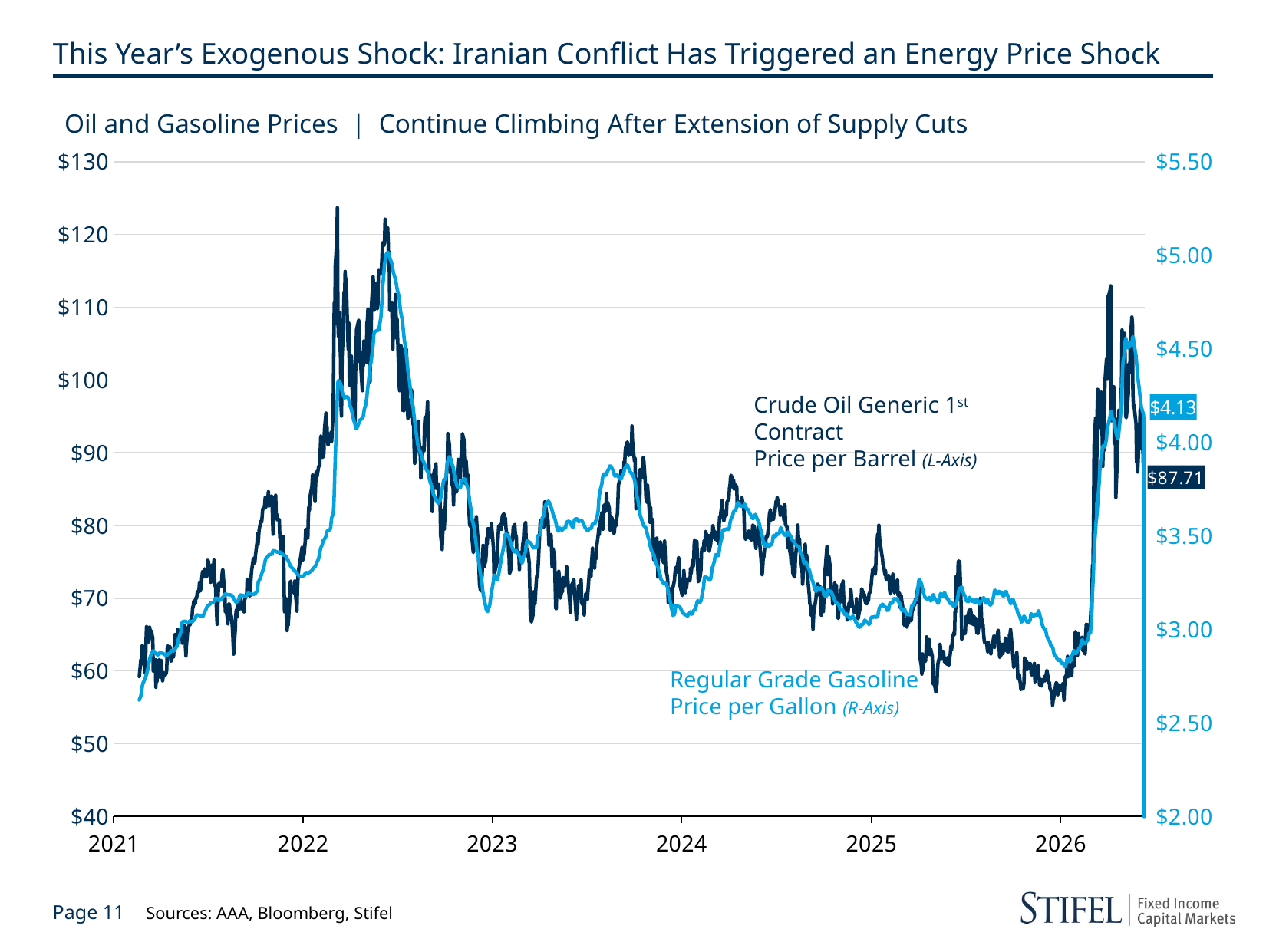
What is the latest labelled value for the Crude Oil Generic 1st Contract Price per Barrel? $87.71 Is the crude oil price per barrel at the start of 2021 greater or less than $70? less What is the latest labelled value for the Regular Grade Gasoline Price per Gallon? $4.13 Is the lowest crude oil price per barrel in late 2025 greater or less than $60? less Is the peak crude oil price per barrel reached in 2022 greater or less than $120? greater Which axis is the Regular Grade Gasoline Price per Gallon plotted against? R-Axis (right axis) How many years are labelled on the x axis? 6 What kind of chart is shown on the slide? line chart Does the crude oil price per barrel rise or fall from its 2022 peak to the end of 2023? fall How many data series are plotted on the chart? 2